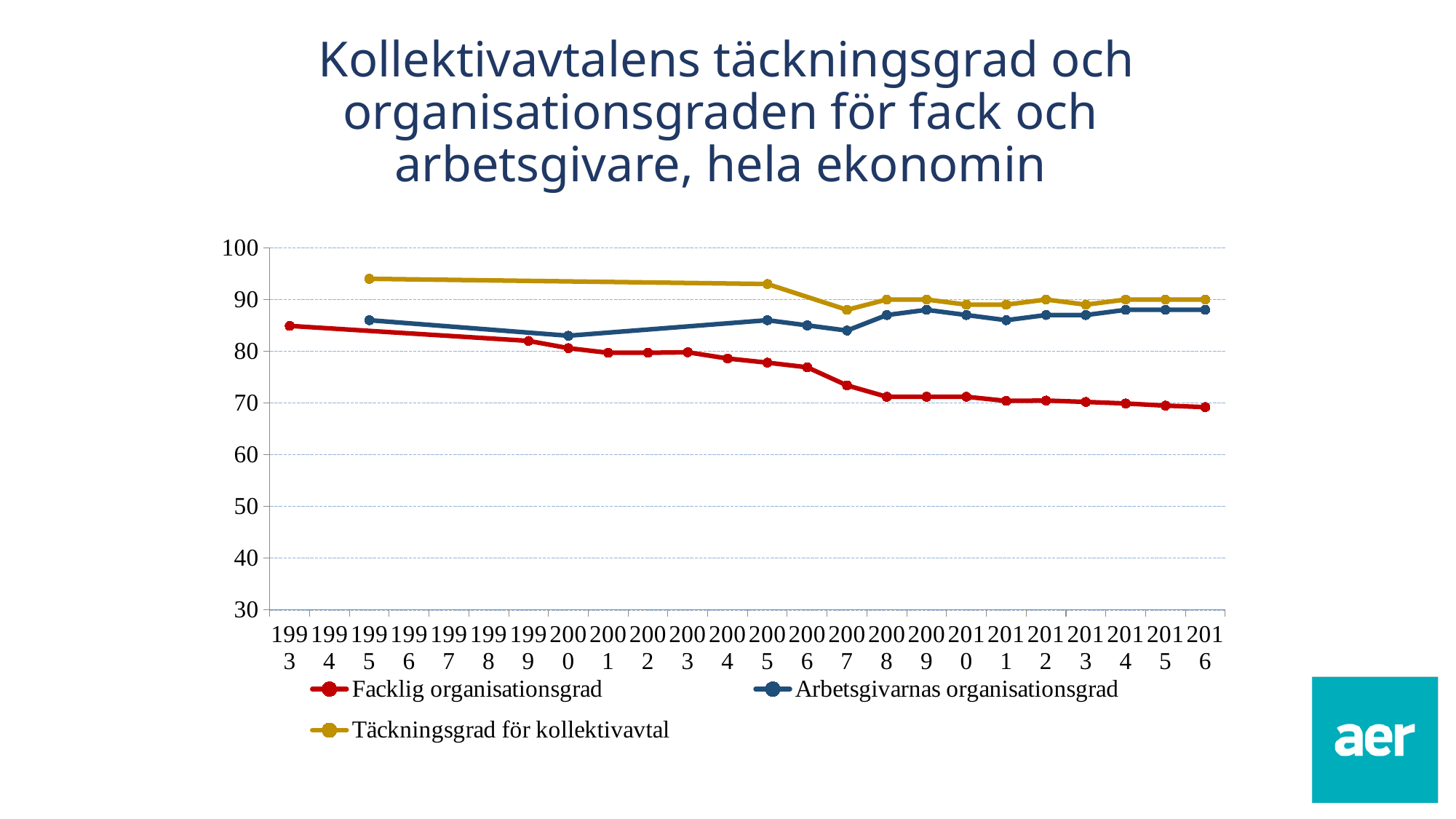
In 2016, which is larger: Täckningsgrad för kollektivavtal or Facklig organisationsgrad? Täckningsgrad för kollektivavtal What colour is the line for Täckningsgrad för kollektivavtal? yellow Does the Facklig organisationsgrad series rise or fall from 1993 to 2016? fall In 2010, which is larger: Arbetsgivarnas organisationsgrad or Facklig organisationsgrad? Arbetsgivarnas organisationsgrad How many years are shown on the x axis? 24 What kind of chart is shown on the slide? line chart In which year is Facklig organisationsgrad highest? 1993 Is the value for Facklig organisationsgrad in 1993 greater or less than 80? greater How many series does the legend list? 3 Is the value for Täckningsgrad för kollektivavtal in 1995 greater or less than 90? greater Is the value for Facklig organisationsgrad in 2016 greater or less than 70? less